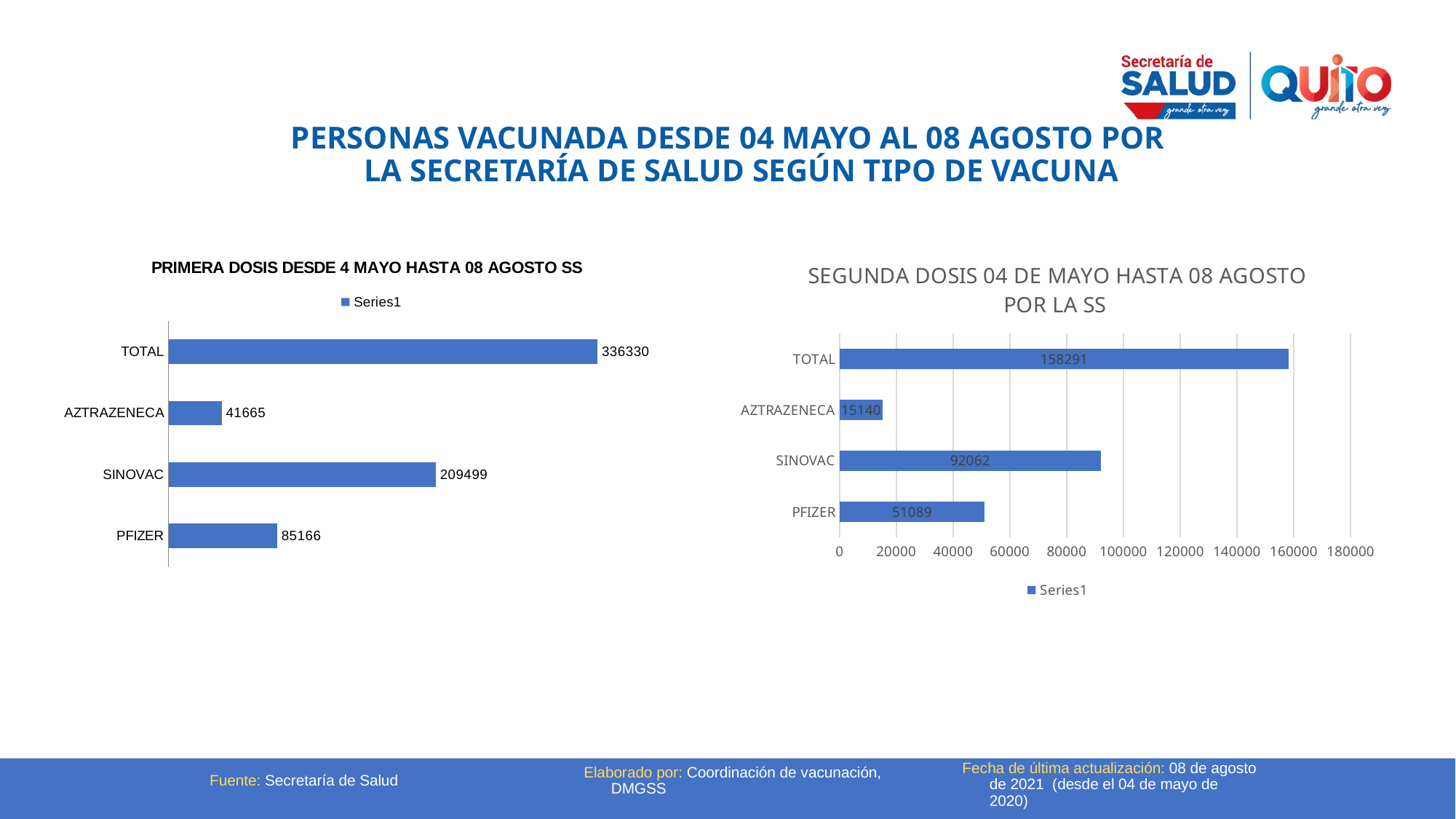
In the 'SEGUNDA DOSIS 04 DE MAYO HASTA 08 AGOSTO POR LA SS' chart, what is the value for TOTAL? 158291 In the 'PRIMERA DOSIS DESDE 4 MAYO HASTA 08 AGOSTO SS' chart, what is the difference between the SINOVAC and PFIZER values? 124333 In the 'SEGUNDA DOSIS 04 DE MAYO HASTA 08 AGOSTO POR LA SS' chart, what is the value for AZTRAZENECA? 15140 In the 'SEGUNDA DOSIS 04 DE MAYO HASTA 08 AGOSTO POR LA SS' chart, what is the difference between the SINOVAC and PFIZER values? 40973 In the 'PRIMERA DOSIS DESDE 4 MAYO HASTA 08 AGOSTO SS' chart, which vaccine type (excluding TOTAL) has the lowest value? AZTRAZENECA In the 'SEGUNDA DOSIS 04 DE MAYO HASTA 08 AGOSTO POR LA SS' chart, which vaccine type (excluding TOTAL) has the highest value? SINOVAC In the 'PRIMERA DOSIS DESDE 4 MAYO HASTA 08 AGOSTO SS' chart, what is the value for PFIZER? 85166 In the 'SEGUNDA DOSIS 04 DE MAYO HASTA 08 AGOSTO POR LA SS' chart, which is larger, the value for PFIZER or the value for AZTRAZENECA? PFIZER What type of chart is the 'SEGUNDA DOSIS 04 DE MAYO HASTA 08 AGOSTO POR LA SS' chart? Bar chart In the 'PRIMERA DOSIS DESDE 4 MAYO HASTA 08 AGOSTO SS' chart, how many bars are shown? 4 In the 'PRIMERA DOSIS DESDE 4 MAYO HASTA 08 AGOSTO SS' chart, what is the value for SINOVAC? 209499 How many series does the legend of the 'PRIMERA DOSIS DESDE 4 MAYO HASTA 08 AGOSTO SS' chart list? 1